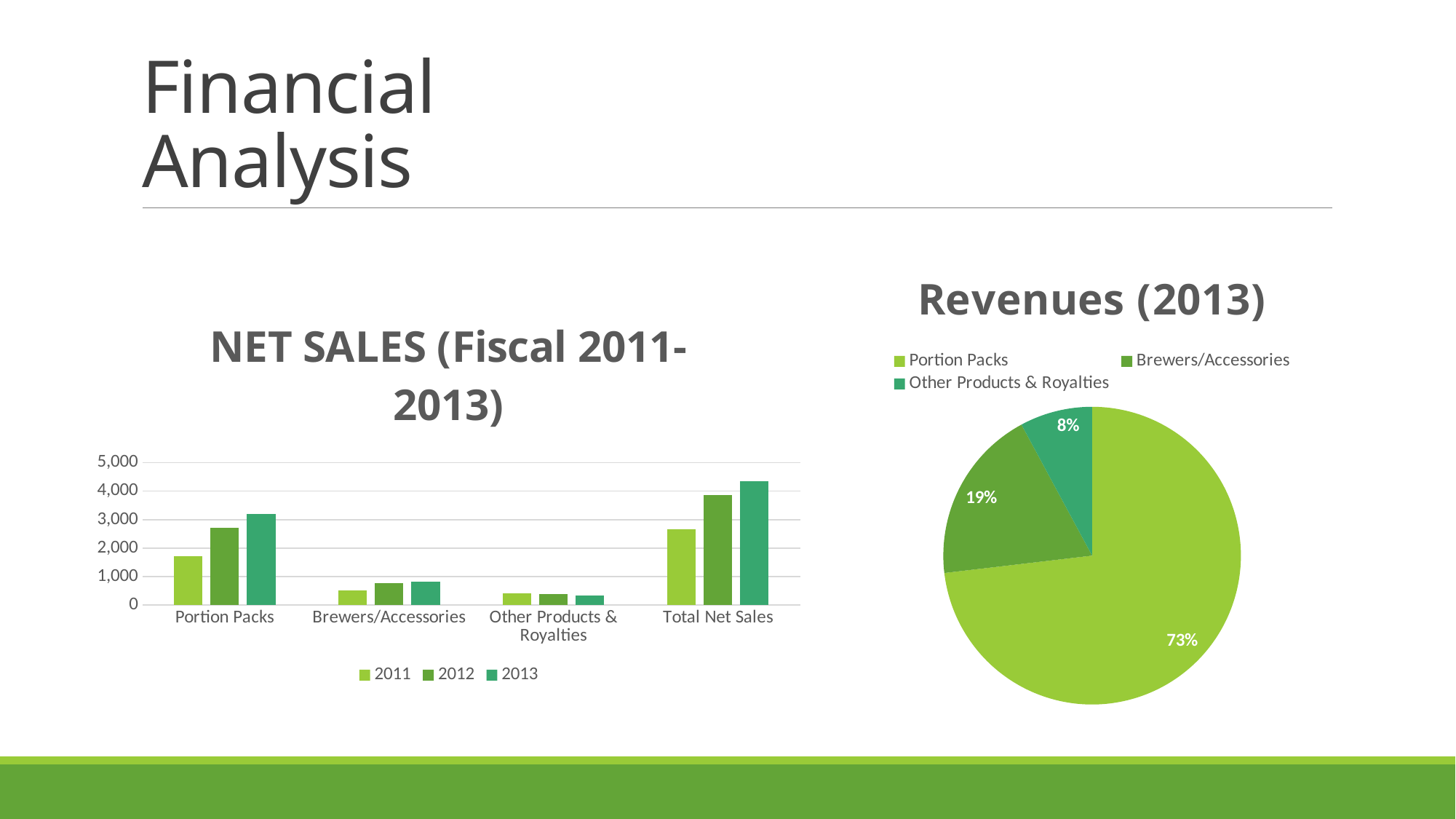
How many series does the legend of the NET SALES (Fiscal 2011-2013) chart list? 3 In the Revenues (2013) pie chart, what is the difference in percentage points between Portion Packs and Brewers/Accessories? 54 How many categories are shown on the x axis of the NET SALES (Fiscal 2011-2013) chart? 4 In the NET SALES (Fiscal 2011-2013) chart, is the 2013 value for Brewers/Accessories greater or less than 1,000? less In the NET SALES (Fiscal 2011-2013) chart, is the 2011 value for Portion Packs greater or less than 2,000? less In the NET SALES (Fiscal 2011-2013) chart, do the Portion Packs values rise or fall from 2011 to 2013? rise In the Revenues (2013) pie chart, what share does Portion Packs have? 73% In the Revenues (2013) pie chart, which slice is the smallest? Other Products & Royalties What kind of chart is the NET SALES (Fiscal 2011-2013) chart? bar chart What kind of chart is the Revenues (2013) chart? pie chart In the NET SALES (Fiscal 2011-2013) chart, is the 2013 value for Total Net Sales greater or less than 4,000? greater In the NET SALES (Fiscal 2011-2013) chart, which category has the highest 2013 bar? Total Net Sales